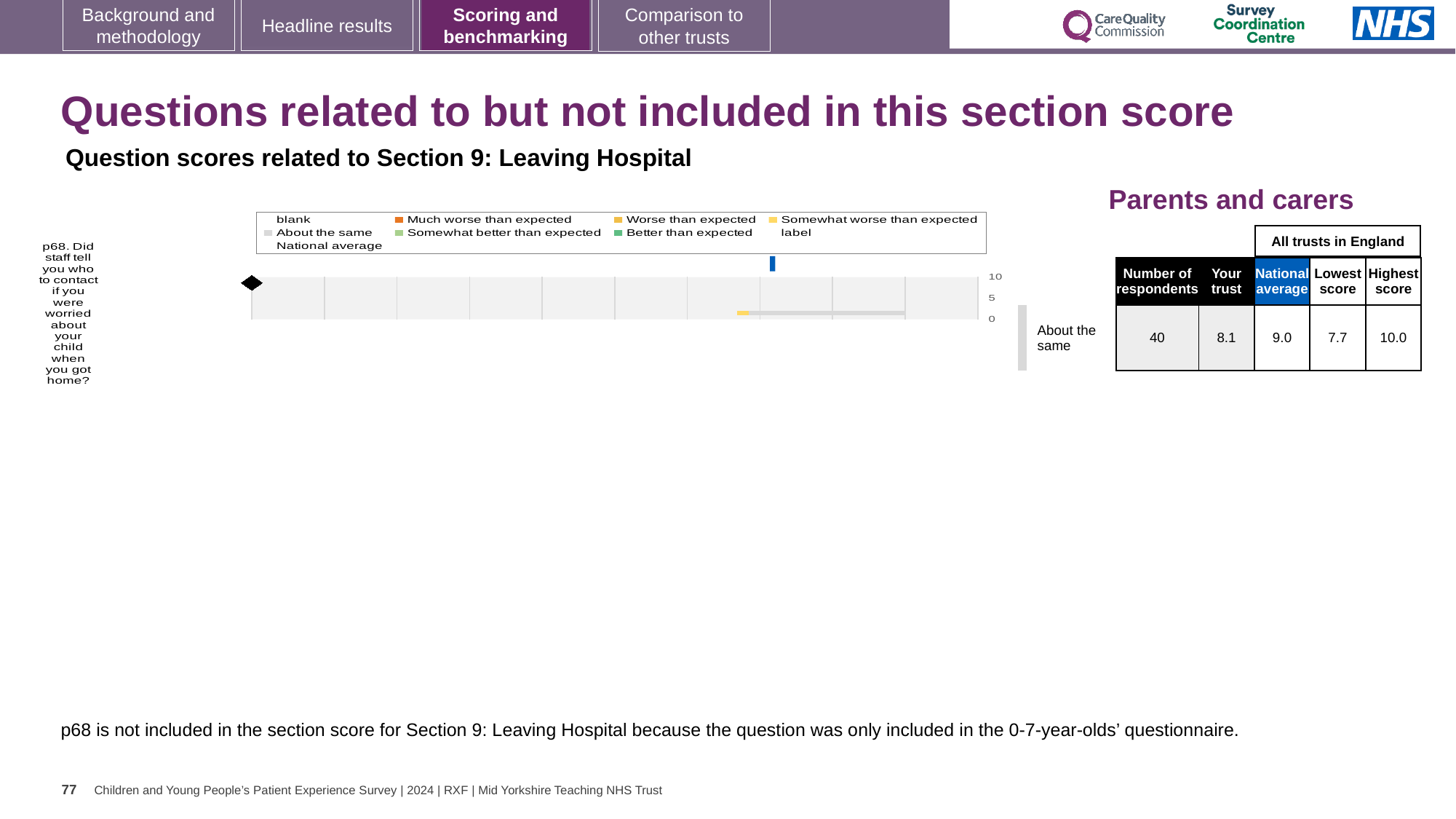
What is the highest score among all trusts in England for p68? 10.0 What is the difference between the national average and the trust's score for p68? 0.9 What is the lowest score among all trusts in England for p68? 7.7 How many respondents answered p68? 40 What kind of chart is used to show the p68 question score? Bar chart What is the national average score for p68? 9.0 What is the 'Your trust' score for p68 shown in the table? 8.1 What benchmark category is the trust's p68 result labelled as? About the same Is the trust's score for p68 greater or less than 5 on the chart axis? greater What is the difference between the highest and lowest scores for p68 across all trusts in England? 2.3 Which is larger for p68: the trust's score or the national average? National average How many questions are plotted in the chart? 1